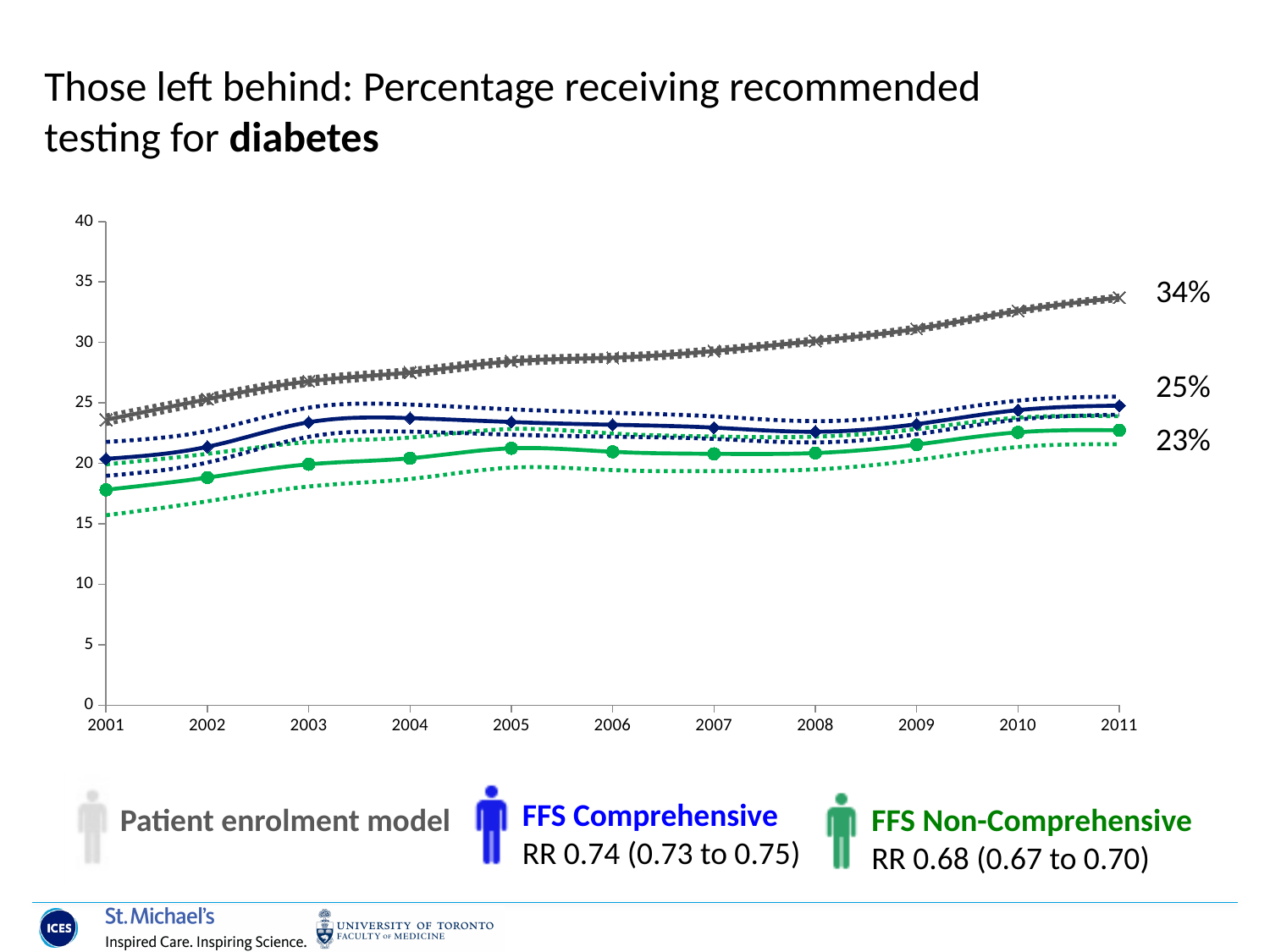
In 2011, which is larger: the FFS Comprehensive value or the FFS Non-Comprehensive value? FFS Comprehensive Which group has the lowest percentage receiving recommended diabetes testing in 2011? FFS Non-Comprehensive Does the Patient enrolment model line rise or fall from 2001 to 2011? rise Is the value for the Patient enrolment model in 2010 greater or less than 30? greater Which group has the highest percentage receiving recommended diabetes testing in 2011? Patient enrolment model What percentage is labelled for the FFS Non-Comprehensive line in 2011? 23% What percentage is labelled for the Patient enrolment model line in 2011? 34% What is the difference in percentage points between the Patient enrolment model and FFS Non-Comprehensive values in 2011? 11 How many years are shown on the x axis of the chart? 11 What percentage is labelled for the FFS Comprehensive line in 2011? 25% What kind of chart is shown on the slide? line chart Is the value for FFS Non-Comprehensive in 2001 greater or less than 20? less